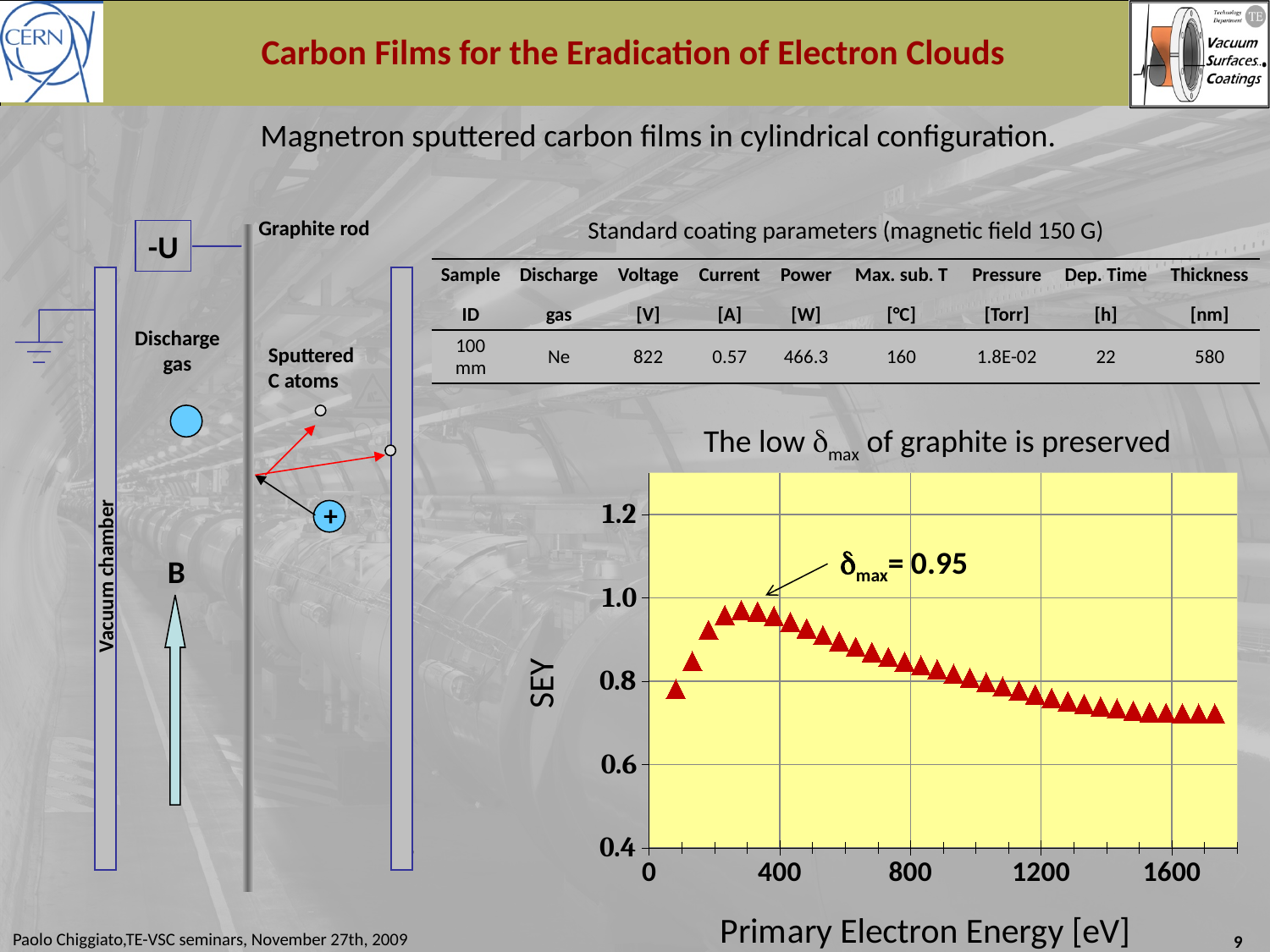
Which has the larger SEY value: the point at 800 eV or the point at 1200 eV? 800 eV Do the SEY values rise or fall as primary electron energy increases from 400 eV to 1600 eV? fall Is the SEY value at a primary electron energy of 400 eV greater or less than 1.0? less What kind of chart is shown on the slide? scatter chart Is the SEY value at a primary electron energy of 1600 eV greater or less than 0.8? less Do the SEY values rise or fall as primary electron energy increases from 0 eV to about 300 eV? rise What is the label of the y axis of the chart? SEY What is the maximum SEY value (δmax) indicated on the chart? 0.95 What is the label of the x axis of the chart? Primary Electron Energy [eV] Which has the larger SEY value: the point at 400 eV or the point at 1600 eV? 400 eV Is the SEY value at a primary electron energy of 800 eV greater or less than 1.0? less